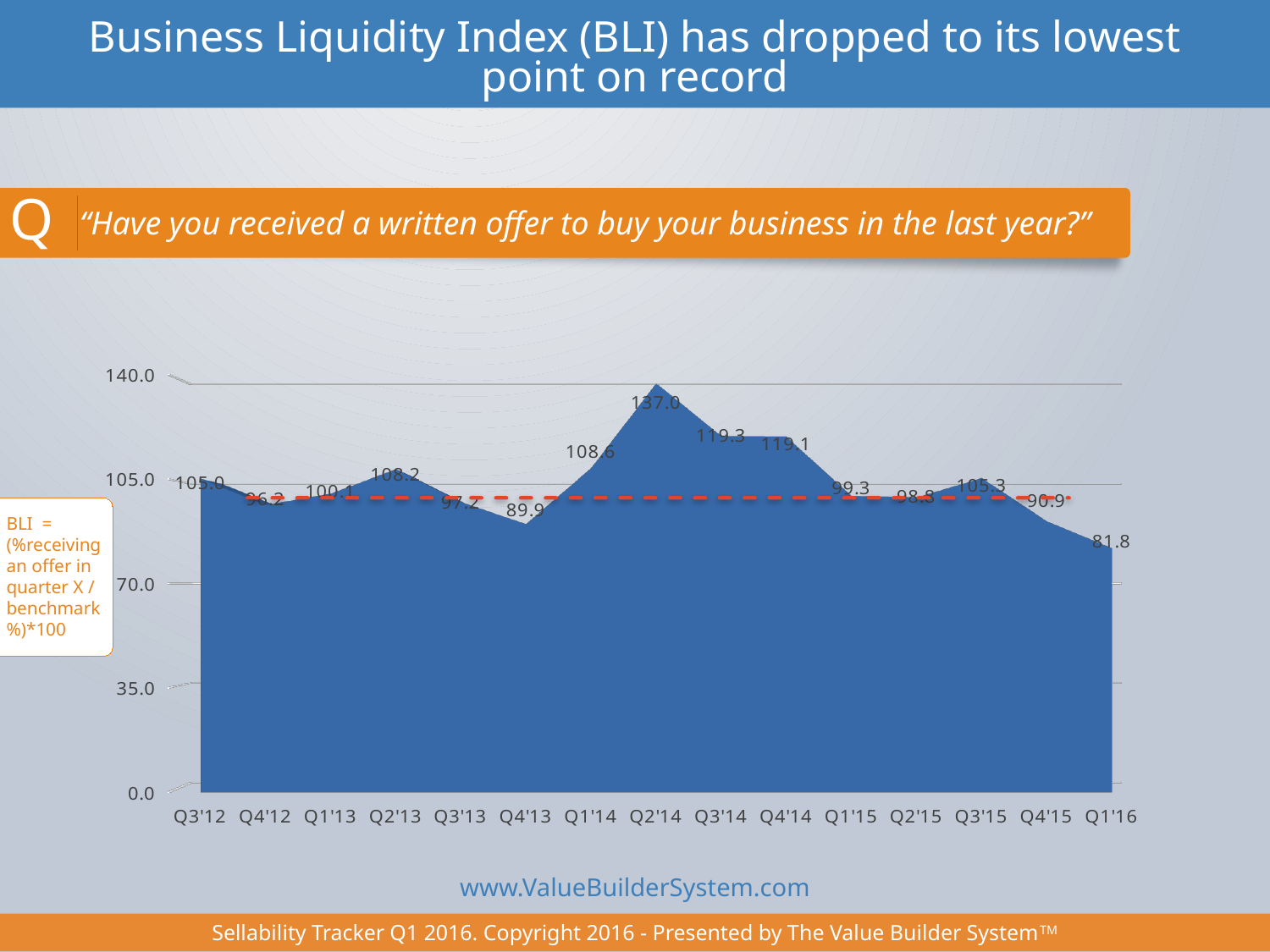
What is the difference between the BLI values for Q2'14 and Q1'16? 55.2 Do the BLI values rise or fall from Q2'14 to Q1'16? fall What is the BLI value for Q4'13? 89.9 How many quarters are plotted on the x axis? 15 What is the BLI value for Q1'16? 81.8 Which quarter has the highest BLI value? Q2'14 Is the BLI value for Q3'14 greater or less than 105.0? greater Which is larger, the BLI value for Q1'14 or for Q2'13? Q1'14 What is the BLI value for Q2'14? 137.0 Which quarter has the lowest BLI value? Q1'16 What kind of chart is shown on the slide? area chart What is the BLI value for Q3'15? 105.3